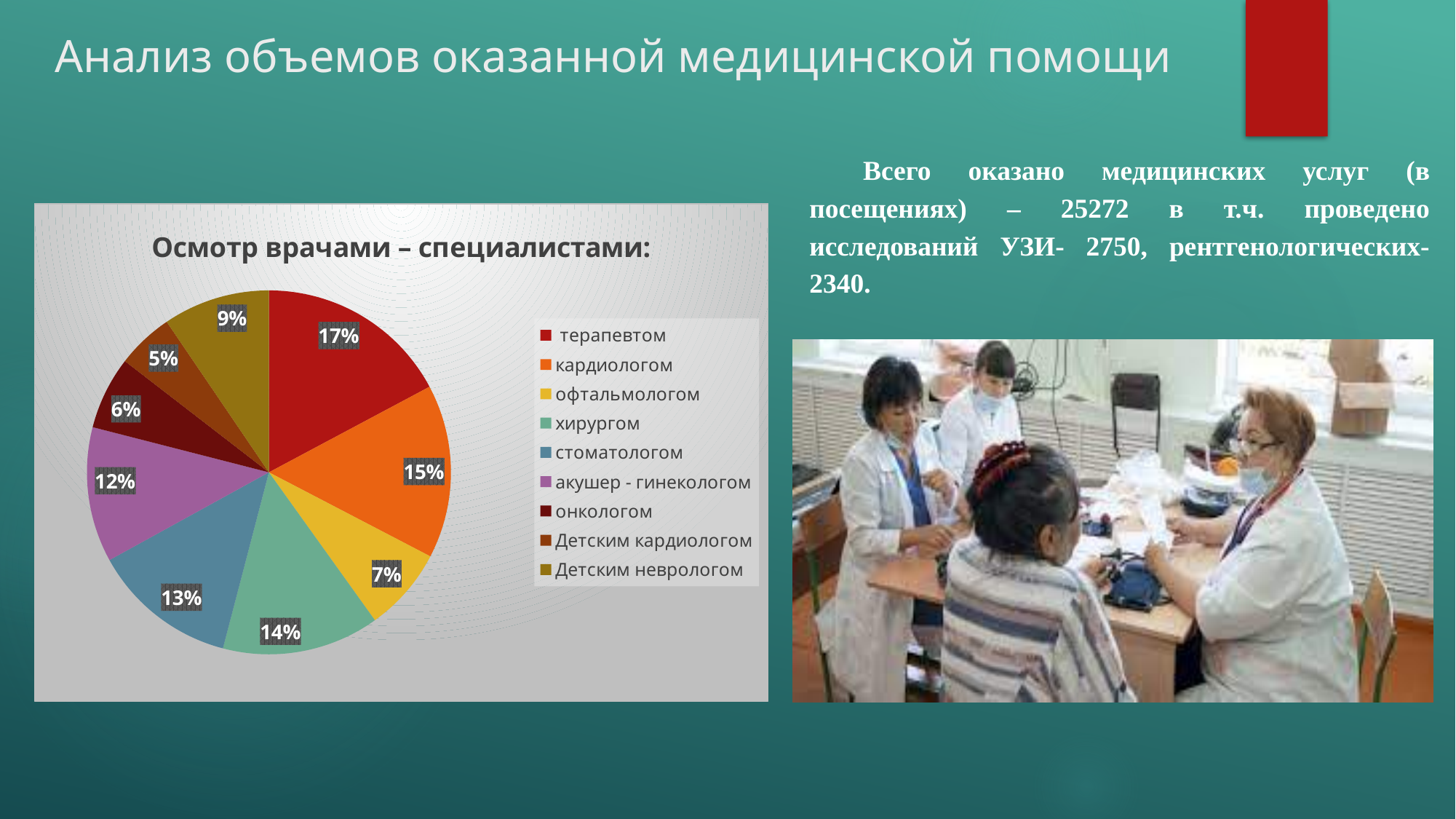
How many slices does the pie chart have? 9 What is the difference between the shares for кардиологом and онкологом? 9% What is the title of the chart? Осмотр врачами – специалистами: What share of the pie is for терапевтом? 17% Which specialist has the largest share of the pie? терапевтом What share of the pie is for стоматологом? 13% Which specialist has the smallest share of the pie? Детским кардиологом Which has a larger share, хирургом or акушер - гинекологом? хирургом What kind of chart is shown on the slide? pie chart What share of the pie is for офтальмологом? 7% What colour is the slice for акушер - гинекологом? purple